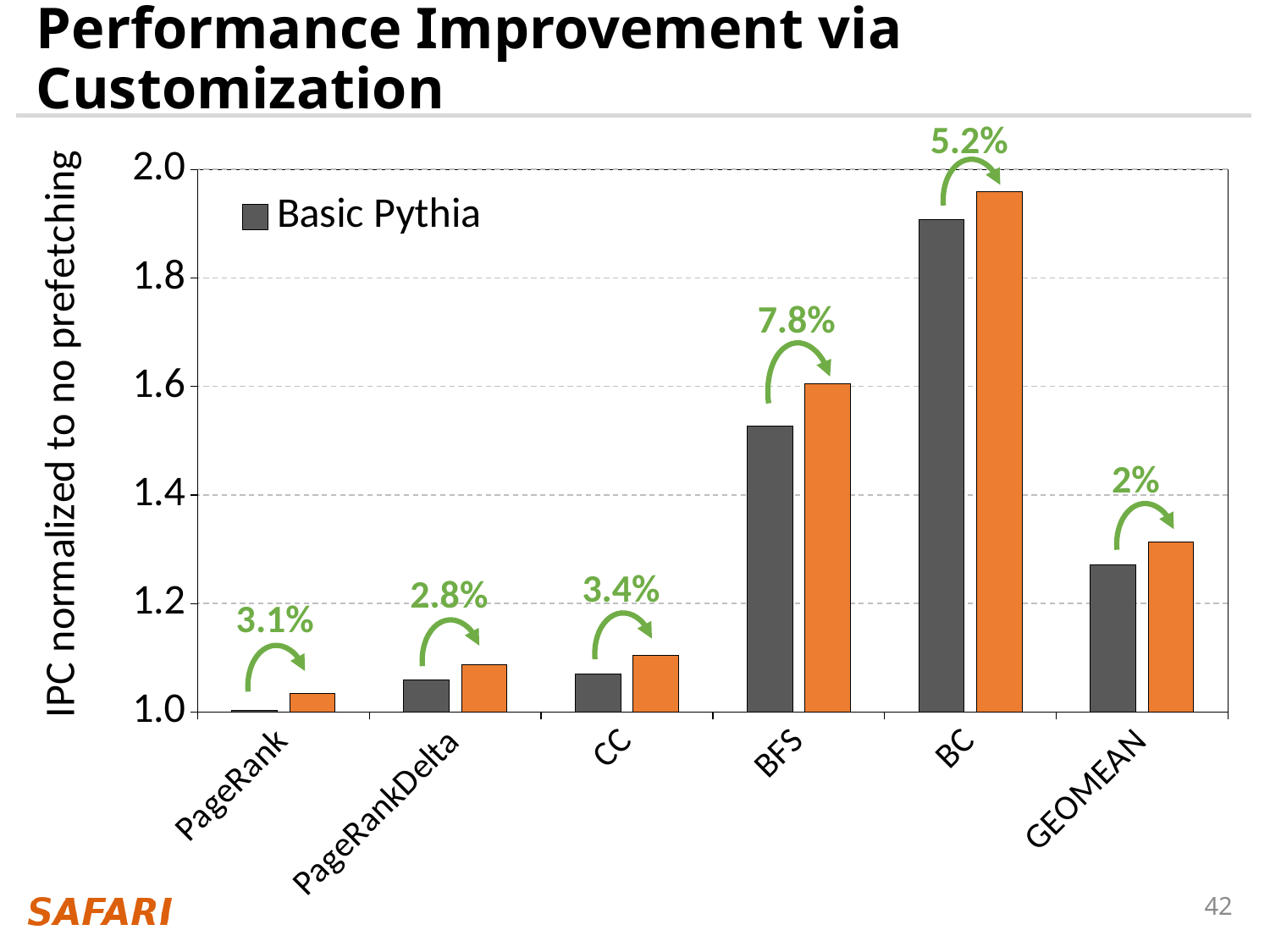
What percentage improvement is annotated above the PageRankDelta bars? 2.8% Which category has the larger Basic Pythia value, BFS or CC? BFS Is the Basic Pythia value for BC greater or less than 1.8? greater What percentage improvement is annotated above the BFS bars? 7.8% How many categories are shown on the x axis of the chart? 6 What percentage improvement is annotated above the GEOMEAN bars? 2% What is the title of the slide's chart? Performance Improvement via Customization What is the label on the y axis of the chart? IPC normalized to no prefetching What type of chart is shown on the slide? bar chart How many series does the chart's legend list? 1 Which category has the lowest Basic Pythia IPC value? PageRank Which category has the highest Basic Pythia IPC value? BC